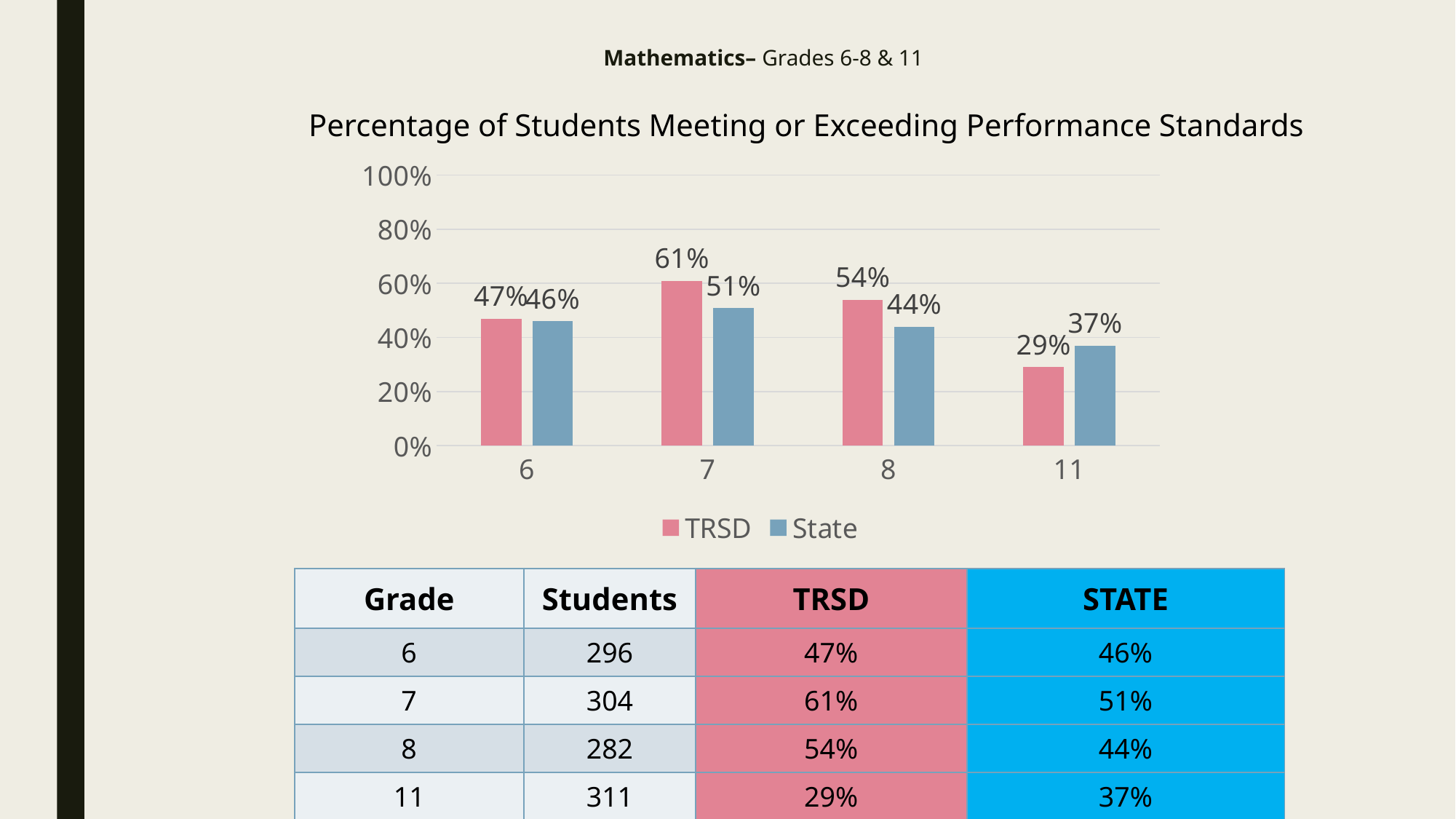
How many series does the legend list? 2 What is the difference between the TRSD and State values for grade 8? 10% Which grade has the lowest State value? 11 For grade 11, which is larger, the TRSD value or the State value? State How many grade categories are shown on the x axis? 4 What is the TRSD value for grade 7? 61% What is the title of the chart? Percentage of Students Meeting or Exceeding Performance Standards What is the State value for grade 8? 44% What kind of chart is shown? bar chart What is the State value for grade 11? 37% Which grade has the highest TRSD value? 7 Is the TRSD value for grade 7 greater or less than 60%? greater